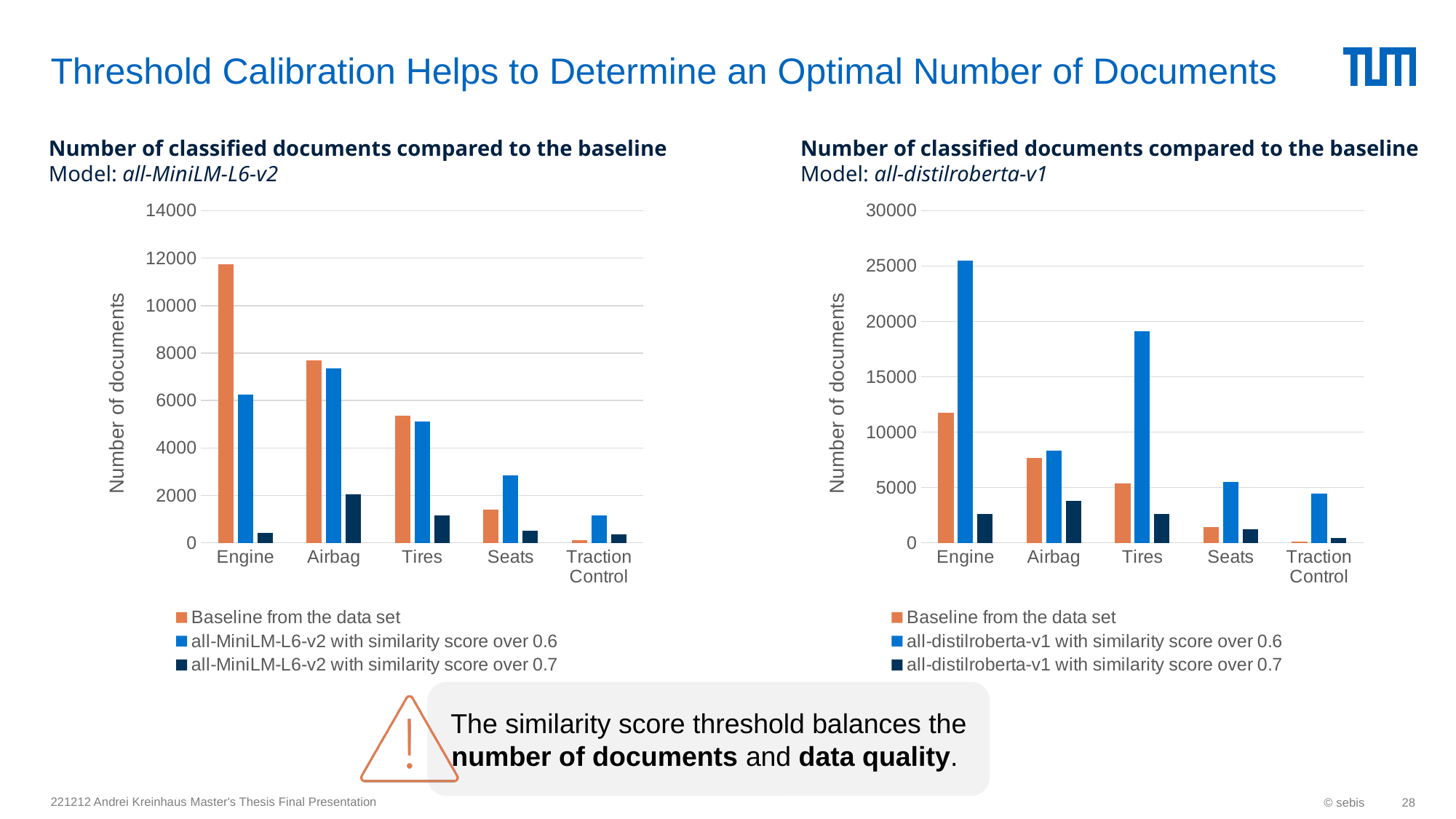
In the right chart (Model: all-distilroberta-v1), is the 'all-distilroberta-v1 with similarity score over 0.6' value for Tires greater or less than 20000? less In the right chart (Model: all-distilroberta-v1), which category has the highest value for 'all-distilroberta-v1 with similarity score over 0.6'? Engine In the left chart (Model: all-MiniLM-L6-v2), is the 'Baseline from the data set' value for Engine greater or less than 10000? greater What kind of chart is the left chart (Model: all-MiniLM-L6-v2)? bar chart In the left chart (Model: all-MiniLM-L6-v2), which category has the highest value for 'Baseline from the data set'? Engine How many categories are shown on the x axis of the right chart (Model: all-distilroberta-v1)? 5 In the right chart (Model: all-distilroberta-v1), is the 'all-distilroberta-v1 with similarity score over 0.6' value for Engine greater or less than 20000? greater How many series does the legend of the left chart (Model: all-MiniLM-L6-v2) list? 3 In the left chart (Model: all-MiniLM-L6-v2), for Seats, which is larger: 'Baseline from the data set' or 'all-MiniLM-L6-v2 with similarity score over 0.6'? all-MiniLM-L6-v2 with similarity score over 0.6 In the left chart (Model: all-MiniLM-L6-v2), which category has the lowest value for 'Baseline from the data set'? Traction Control What is the y-axis label of the right chart (Model: all-distilroberta-v1)? Number of documents In the left chart (Model: all-MiniLM-L6-v2), do the 'Baseline from the data set' values rise or fall from Engine to Traction Control? fall